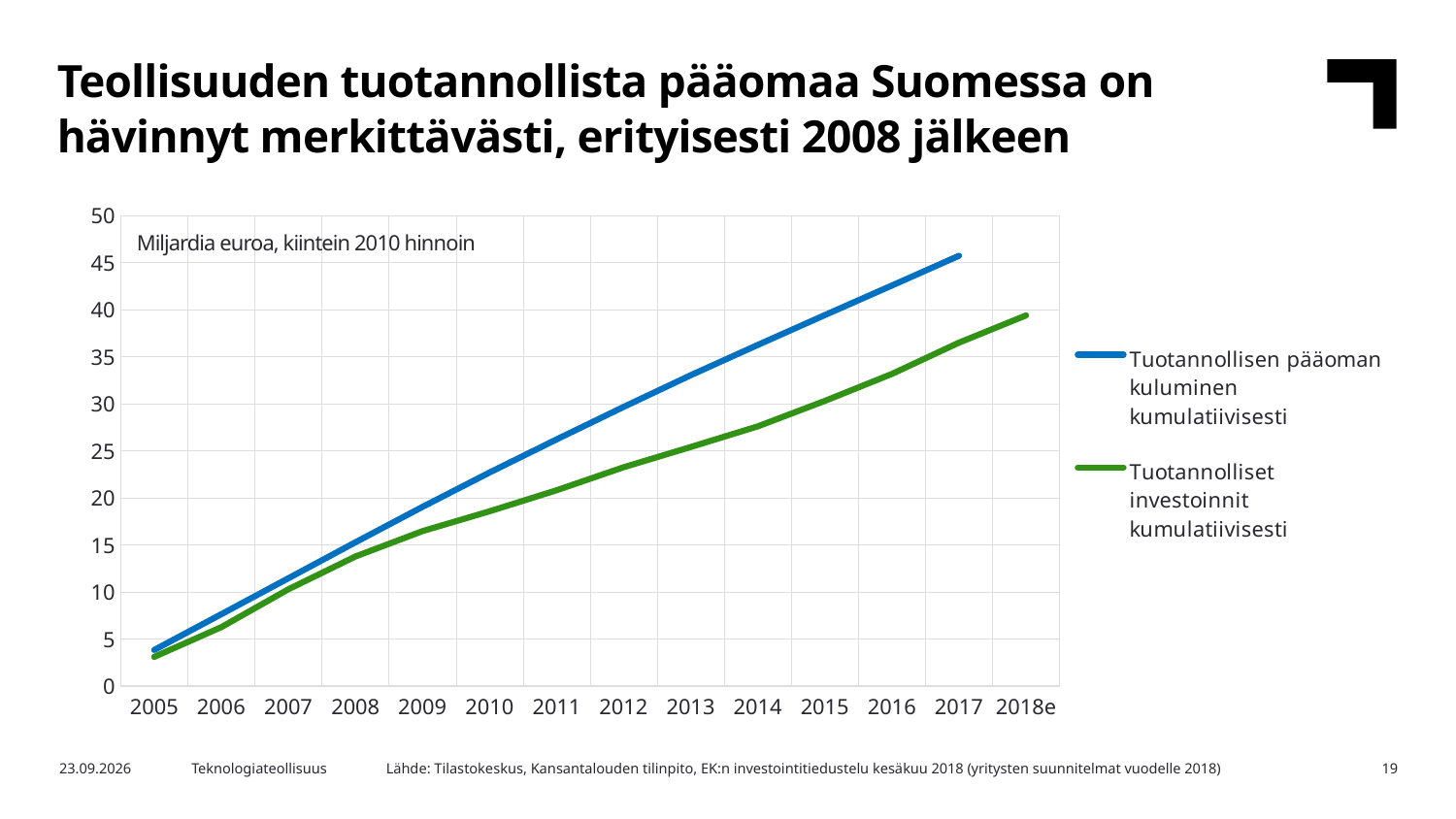
In which year is the 'Tuotannolliset investoinnit kumulatiivisesti' series at its lowest? 2005 Is the value for 'Tuotannolliset investoinnit kumulatiivisesti' in 2012 greater or less than 25? less What unit is stated in the note inside the chart area? Miljardia euroa, kiintein 2010 hinnoin How many series does the legend list? 2 Do the values of the 'Tuotannollisen pääoman kuluminen kumulatiivisesti' series rise or fall from 2005 to 2018e? rise How many years are shown on the x axis? 14 What kind of chart is shown on the slide? line chart Is the value for 'Tuotannollisen pääoman kuluminen kumulatiivisesti' in 2005 greater or less than 5? less Do the values of the 'Tuotannolliset investoinnit kumulatiivisesti' series rise or fall along the x axis? rise In which year is the 'Tuotannollisen pääoman kuluminen kumulatiivisesti' series at its highest? 2017